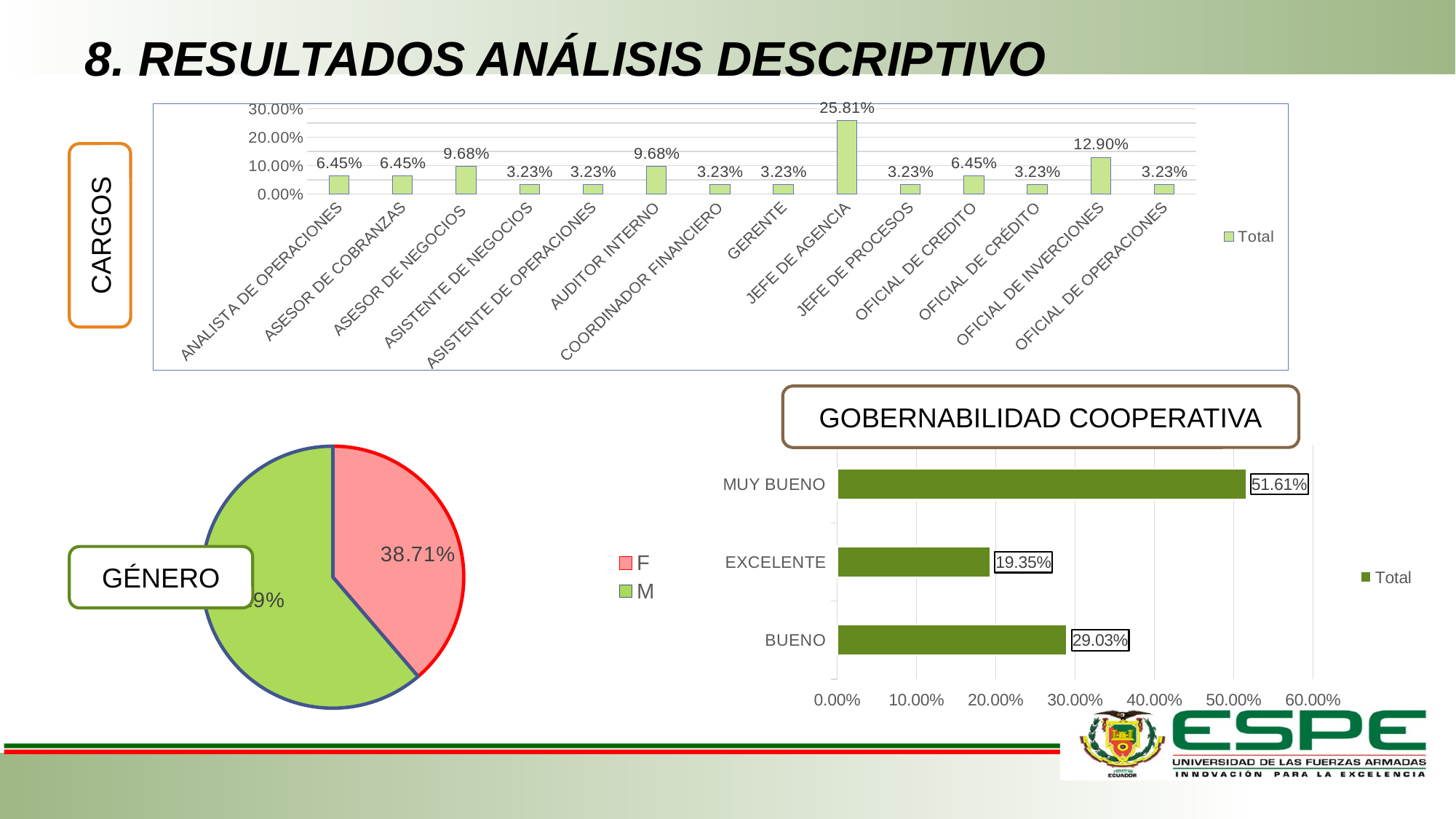
What kind of chart is the GÉNERO chart? Pie chart In the CARGOS chart, what is the difference between JEFE DE AGENCIA and OFICIAL DE INVERCIONES? 12.91% In the GÉNERO pie chart, what is the share for F? 38.71% In the CARGOS chart, what is the value for JEFE DE AGENCIA? 25.81% In the CARGOS chart, which category has the highest value? JEFE DE AGENCIA In the CARGOS chart, which is larger, AUDITOR INTERNO or GERENTE? AUDITOR INTERNO In the CARGOS chart, what is the value for OFICIAL DE INVERCIONES? 12.90% In the GÉNERO pie chart, which slice is larger, F or M? M How many categories are shown in the CARGOS chart? 14 In the GOBERNABILIDAD COOPERATIVA chart, what is the difference between BUENO and EXCELENTE? 9.68% In the GOBERNABILIDAD COOPERATIVA chart, what is the value for MUY BUENO? 51.61% In the GOBERNABILIDAD COOPERATIVA chart, which category has the lowest value? EXCELENTE